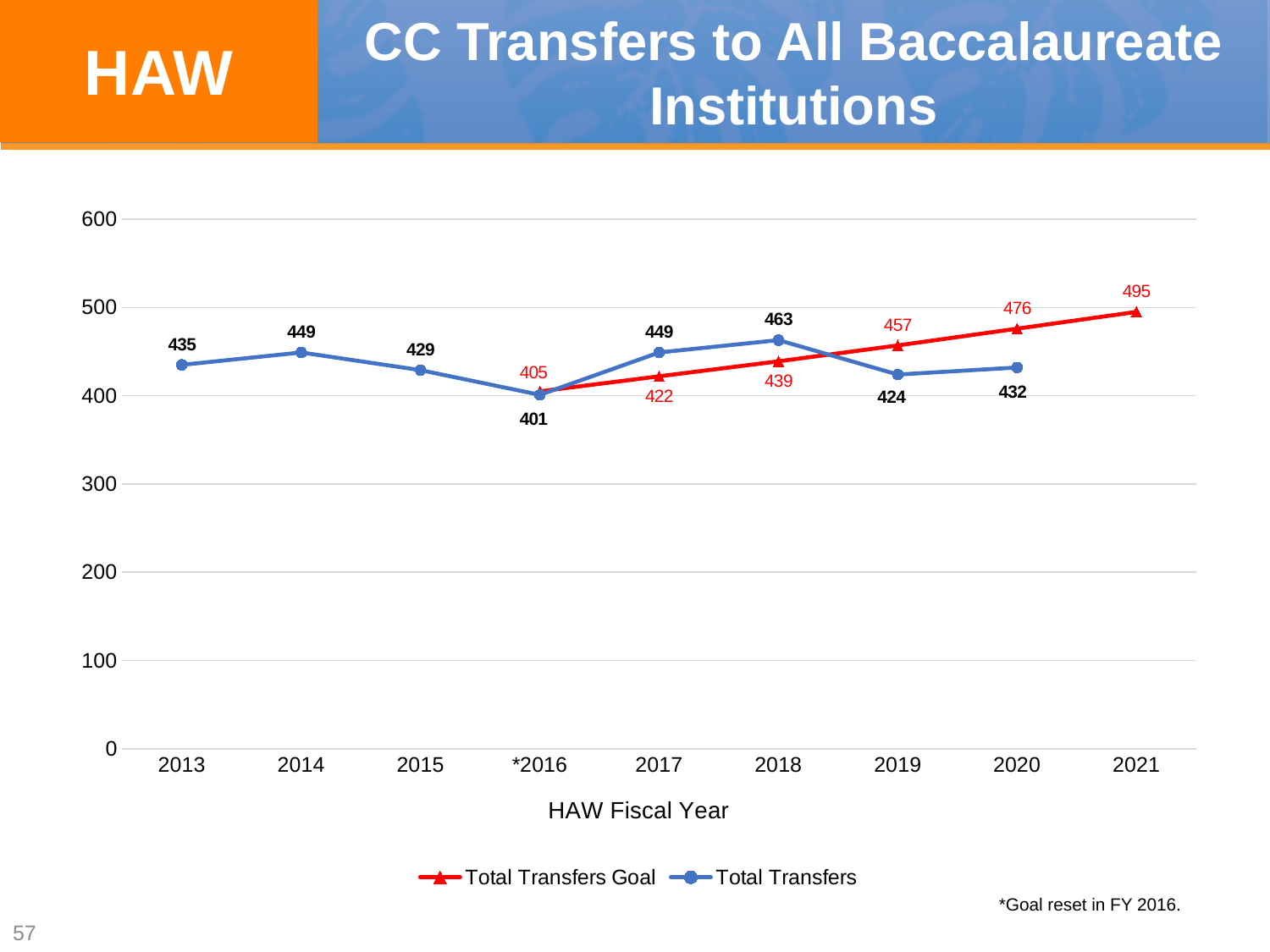
What is the Total Transfers Goal value for 2021? 495 What is the Total Transfers value for 2018? 463 What kind of chart is shown on the slide? Line chart What is the difference between the Total Transfers Goal and the Total Transfers in 2020? 44 Which fiscal year has the highest Total Transfers value? 2018 How many series does the legend list? 2 Which fiscal year has the lowest Total Transfers value? *2016 In 2019, which is larger: Total Transfers Goal or Total Transfers? Total Transfers Goal How many fiscal years are shown on the x axis? 9 Does the Total Transfers Goal series rise or fall from *2016 to 2021? Rise What is the x-axis title of the chart? HAW Fiscal Year What is the Total Transfers value for *2016? 401